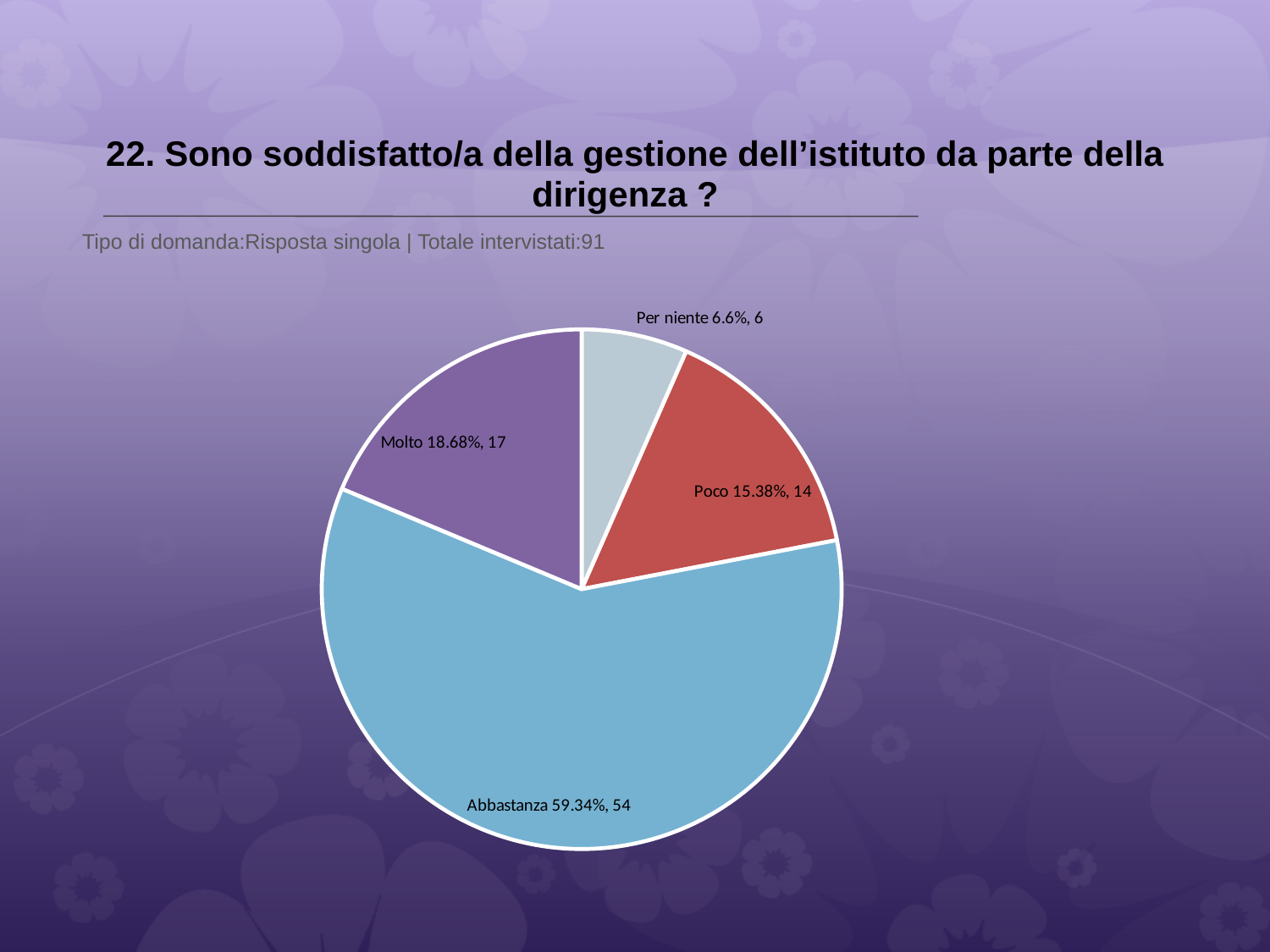
What percentage share does the 'Per niente' slice have? 6.6% What is the difference in respondent count between 'Abbastanza' and 'Molto'? 37 What kind of chart is shown on the slide? pie chart What is the total number of respondents stated on the slide? 91 How many respondents answered 'Molto'? 17 What percentage share does the 'Abbastanza' slice have? 59.34% Which category has the smallest slice? Per niente How many respondents answered 'Poco'? 14 Which category has the largest slice? Abbastanza Which has more respondents, 'Molto' or 'Poco'? Molto What colour is the 'Abbastanza' slice? light blue How many slices does the pie chart have? 4